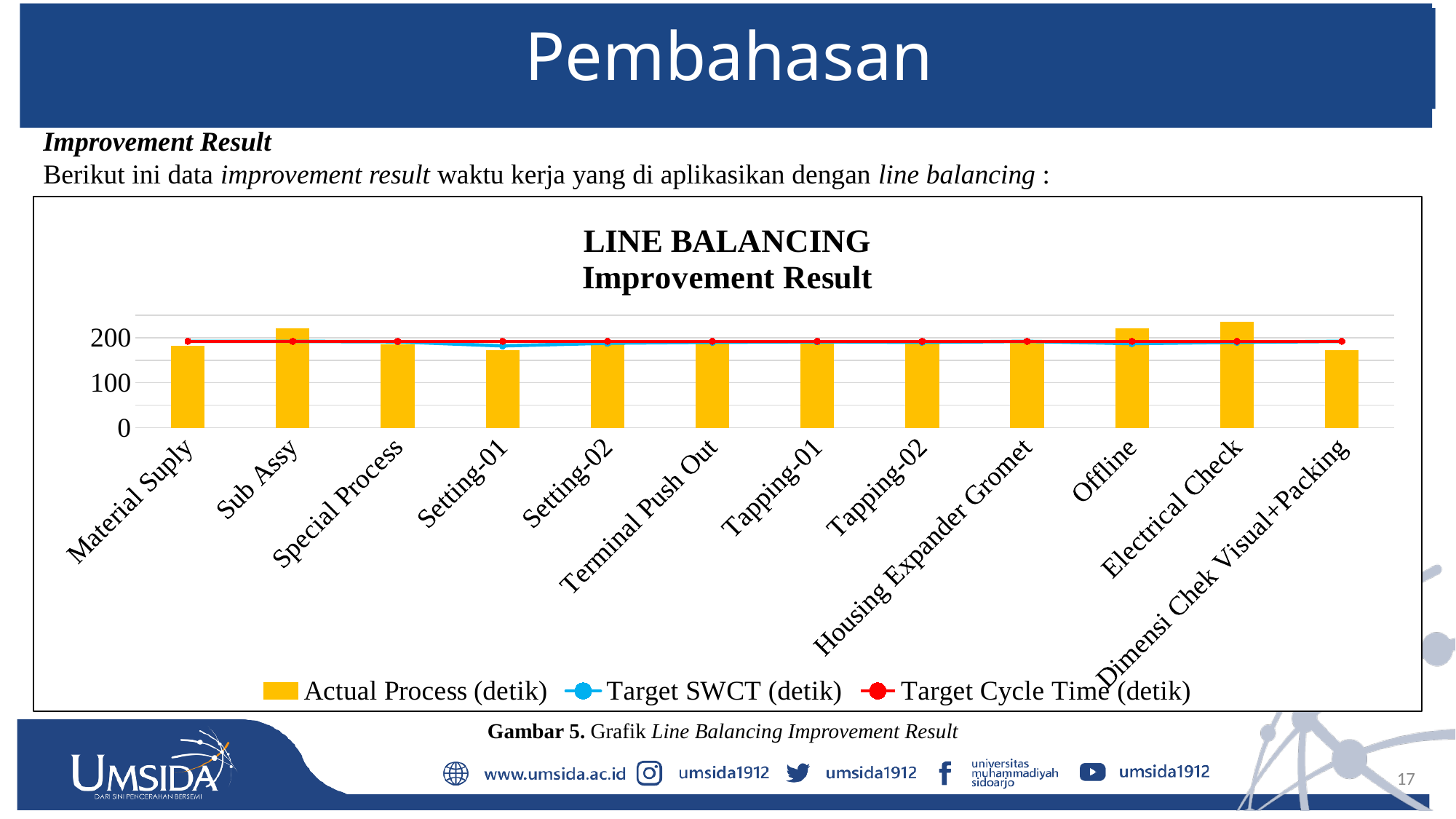
How many categories are shown on the x axis of the chart? 12 How many series does the chart legend list? 3 Which series in the legend is drawn with a red line? Target Cycle Time (detik) Is the Actual Process (detik) value for Material Suply greater or less than 200? less Which category has the highest Actual Process (detik) bar? Electrical Check What kind of chart is shown on the slide? Combination bar and line chart What is the title of the chart? LINE BALANCING Improvement Result Is the Actual Process (detik) value for Dimensi Chek Visual+Packing greater or less than 200? less Is the Actual Process (detik) value for Sub Assy greater or less than 200? greater Which has a larger Actual Process (detik) value, Sub Assy or Material Suply? Sub Assy